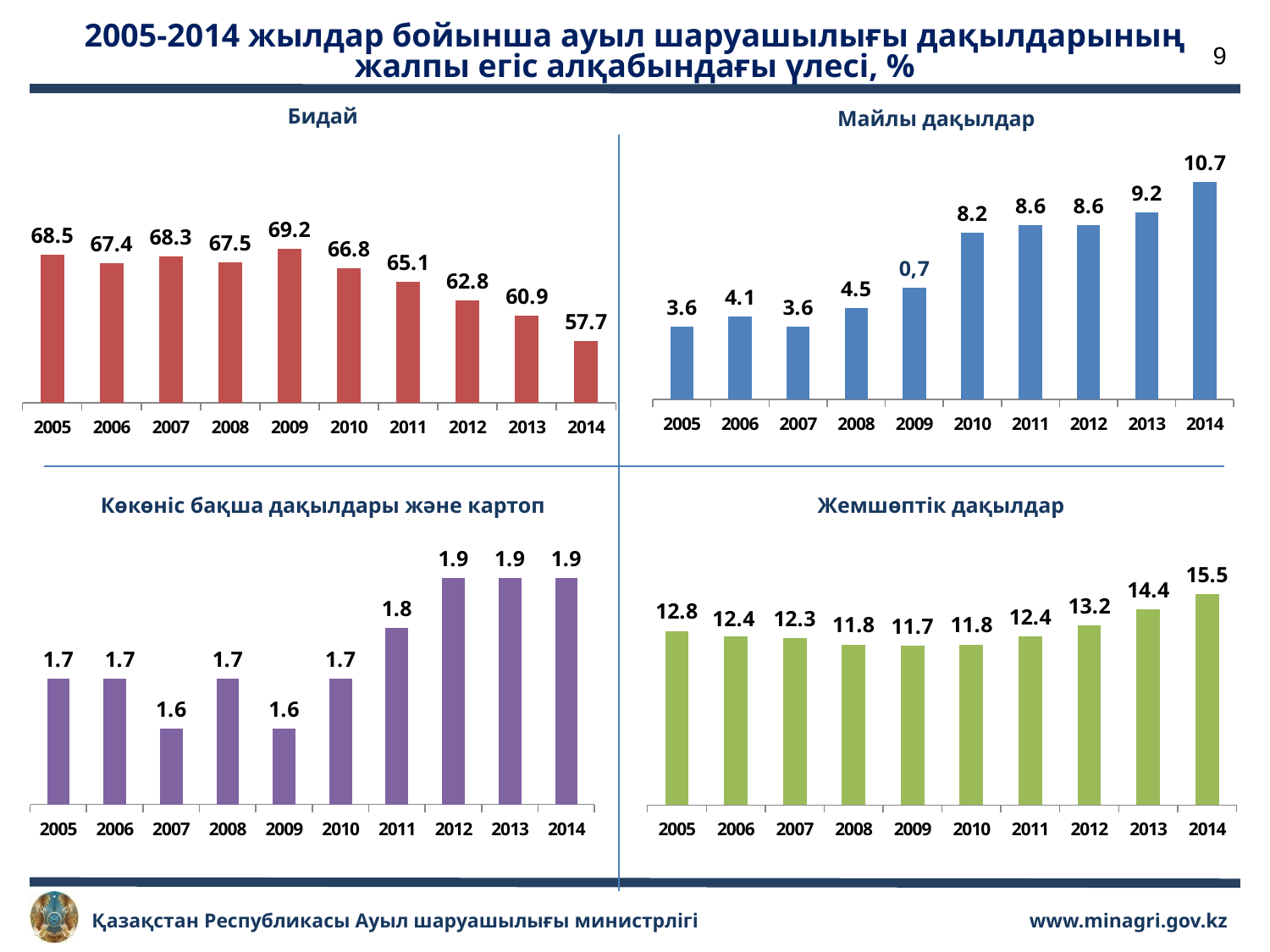
In the Бидай chart, which year has the lowest value? 2014 In the Бидай chart, what is the value for 2009? 69.2 In the Бидай chart, what is the difference between the 2005 value and the 2014 value? 10.8 In the Жемшөптік дақылдар chart, what is the value for 2013? 14.4 In the Майлы дақылдар chart, which is larger, the value for 2006 or the value for 2008? 2008 In the Майлы дақылдар chart, which year has the highest value? 2014 In the Көкөніс бақша дақылдары және картоп chart, how many years are shown on the x axis? 10 In the Көкөніс бақша дақылдары және картоп chart, what is the value for 2011? 1.8 What kind of chart is the Бидай chart? Bar chart In the Жемшөптік дақылдар chart, which year has the lowest value? 2009 In the Майлы дақылдар chart, what is the value for 2014? 10.7 In the Жемшөптік дақылдар chart, what is the difference between the 2014 value and the 2012 value? 2.3